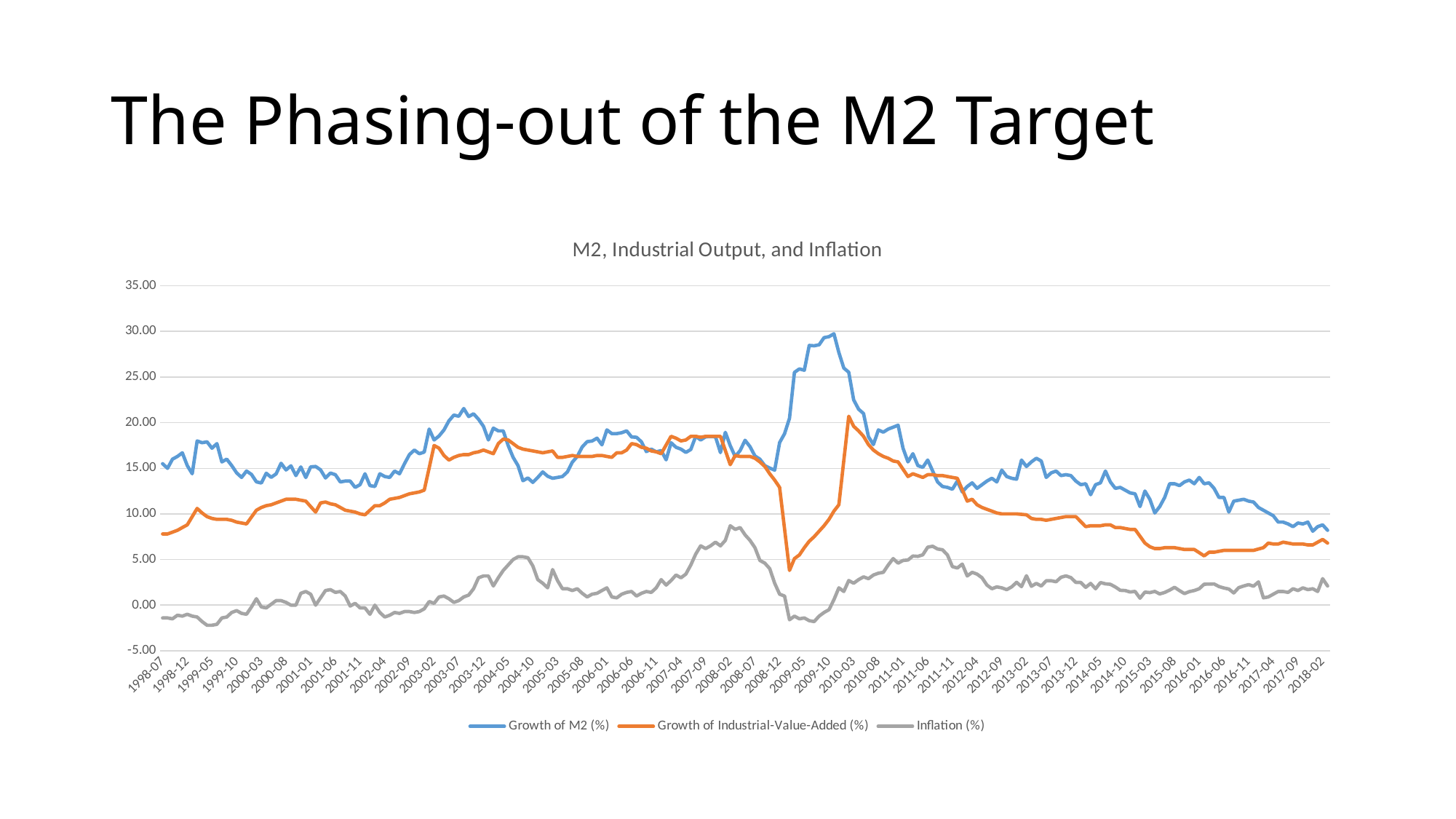
How many series does the legend list? 3 Is the value for Inflation (%) around 2009-05 greater or less than 0.00? less Is the value for Growth of M2 (%) at its peak around 2009-10 greater or less than 25.00? greater Around 2009-05, which is higher: Growth of M2 (%) or Growth of Industrial-Value-Added (%)? Growth of M2 (%) At 2018-02, which is higher: Growth of M2 (%) or Inflation (%)? Growth of M2 (%) Which series is drawn in grey? Inflation (%) Is the value for Growth of M2 (%) at 1998-07 greater or less than 10.00? greater Does Growth of M2 (%) generally rise or fall from 2013-07 to 2018-02? fall What kind of chart is shown on the slide? Line chart Which series reaches the highest value anywhere on the chart? Growth of M2 (%) What is the title of the chart? M2, Industrial Output, and Inflation